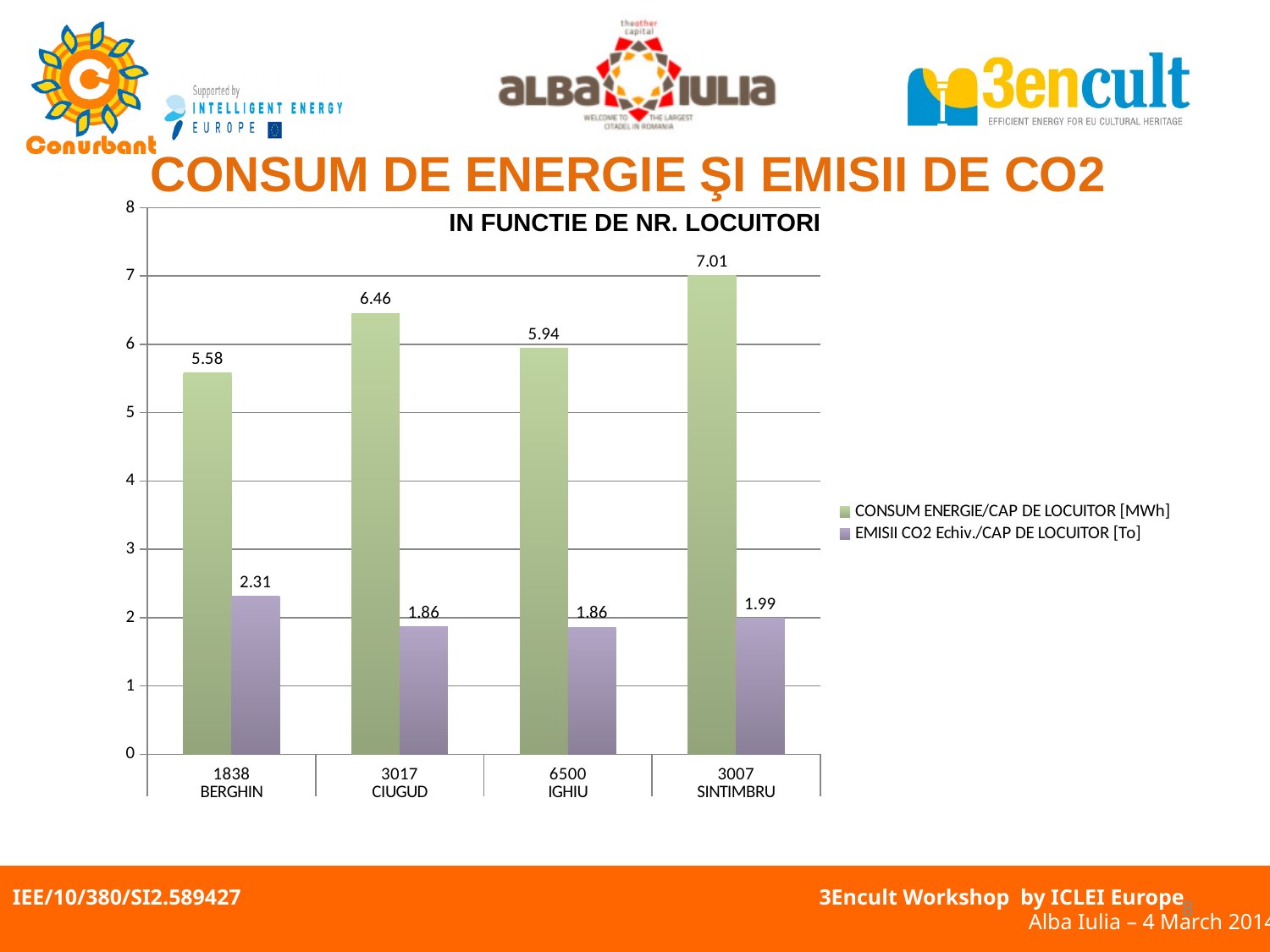
Which locality has the highest CONSUM ENERGIE/CAP DE LOCUITOR [MWh]? SINTIMBRU What is the population number shown under CIUGUD on the x axis? 3017 How many localities are shown on the x axis of the chart? 4 What is the EMISII CO2 Echiv./CAP DE LOCUITOR [To] value for SINTIMBRU? 1.99 What is the CONSUM ENERGIE/CAP DE LOCUITOR [MWh] value for BERGHIN? 5.58 What is the difference between the CONSUM ENERGIE/CAP DE LOCUITOR [MWh] values for SINTIMBRU and BERGHIN? 1.43 How many series does the legend list? 2 What is the CONSUM ENERGIE/CAP DE LOCUITOR [MWh] value for IGHIU? 5.94 Which is larger, the CONSUM ENERGIE/CAP DE LOCUITOR [MWh] for CIUGUD or for IGHIU? CIUGUD What kind of chart is shown on the slide? Bar chart Which locality has the lowest CONSUM ENERGIE/CAP DE LOCUITOR [MWh]? BERGHIN Which locality has the highest EMISII CO2 Echiv./CAP DE LOCUITOR [To]? BERGHIN